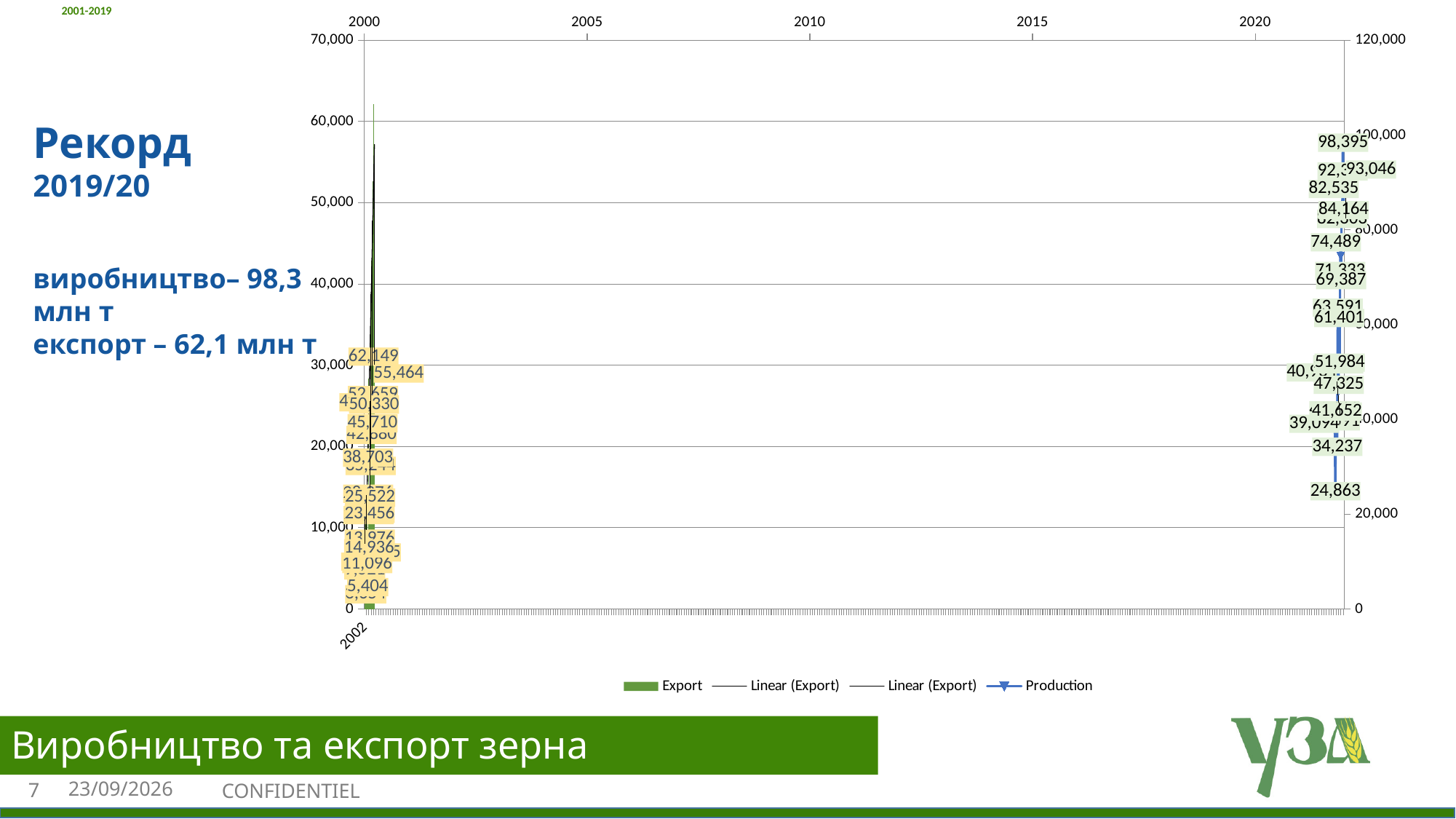
What is the highest Production value labelled on the chart? 98,395 Is the highest labelled Production value greater or less than 80,000? greater What is the difference between the highest labelled Production value (98,395) and the highest labelled Export value (62,149)? 36,246 Which is larger, the highest labelled Production value or the highest labelled Export value? Production (98,395) What kind of chart is shown on the slide? Combined bar and line chart What is the highest Export value labelled on the chart? 62,149 Which series is drawn as green bars in the chart? Export How many entries does the chart legend list? 4 Is the lowest labelled Production value (24,863) greater or less than 20,000? greater How many year tick labels are shown along the top axis of the chart? 5 Which series is drawn as a blue line with markers in the chart? Production Is the highest labelled Export value greater or less than 70,000? less